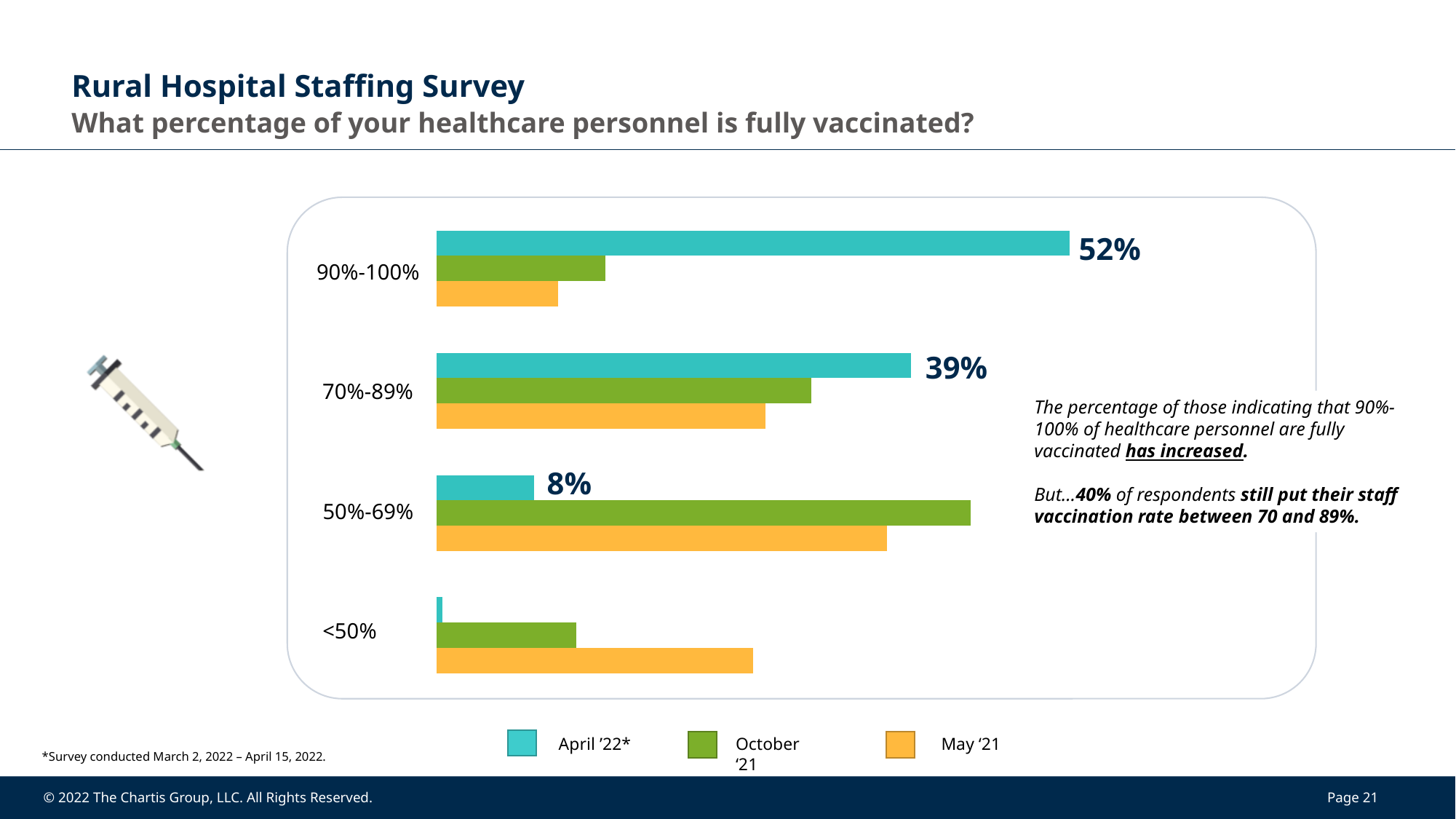
What is the April '22 value for the 70%-89% category? 39% Which category has the longest May '21 bar? 50%-69% What is the difference between the April '22 values for 90%-100% and 70%-89%? 13% What is the April '22 value for the 50%-69% category? 8% How many vaccination-rate categories are shown on the chart? 4 For October '21, which is larger: the 50%-69% bar or the 90%-100% bar? 50%-69% Which category has the highest April '22 value? 90%-100% How many series does the legend list? 3 What kind of chart is shown on the slide? bar chart Which category has the lowest April '22 value? <50% What is the April '22 value for the 90%-100% category? 52% Which series is shown in orange in the legend? May '21